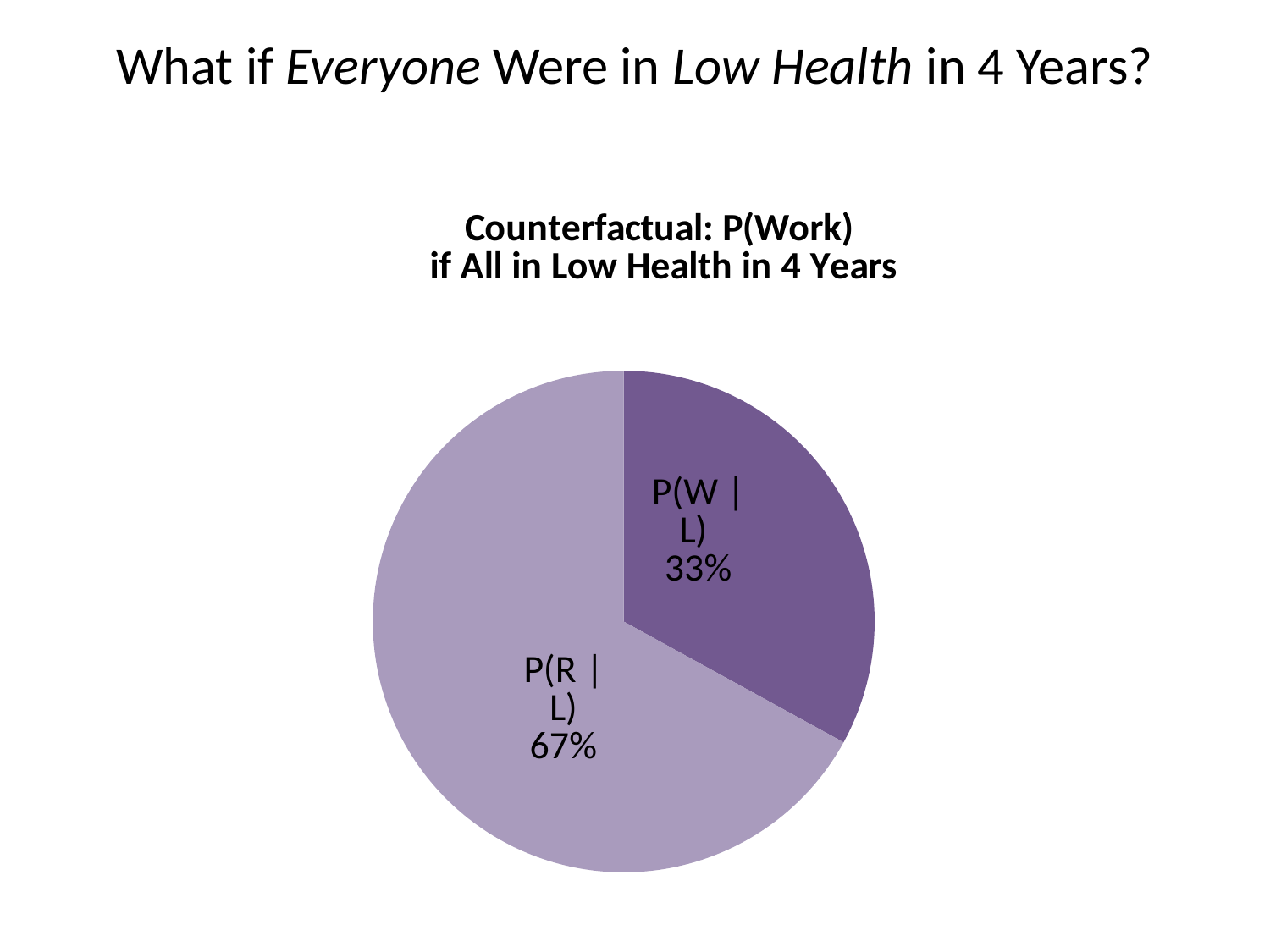
Which slice is shown in the darker purple colour? P(W | L) Which slice is the largest? P(R | L) Which is larger, P(W | L) or P(R | L)? P(R | L) What share of the pie does the P(W | L) slice take? 33% What is the difference between the P(R | L) and P(W | L) slices? 34% What is the value shown for the P(R | L) slice? 67% What is the title of the chart? Counterfactual: P(Work) if All in Low Health in 4 Years Which slice is the smallest? P(W | L) What kind of chart is shown on the slide? pie chart How many slices does the pie chart have? 2 What is the value shown for the P(W | L) slice? 33%